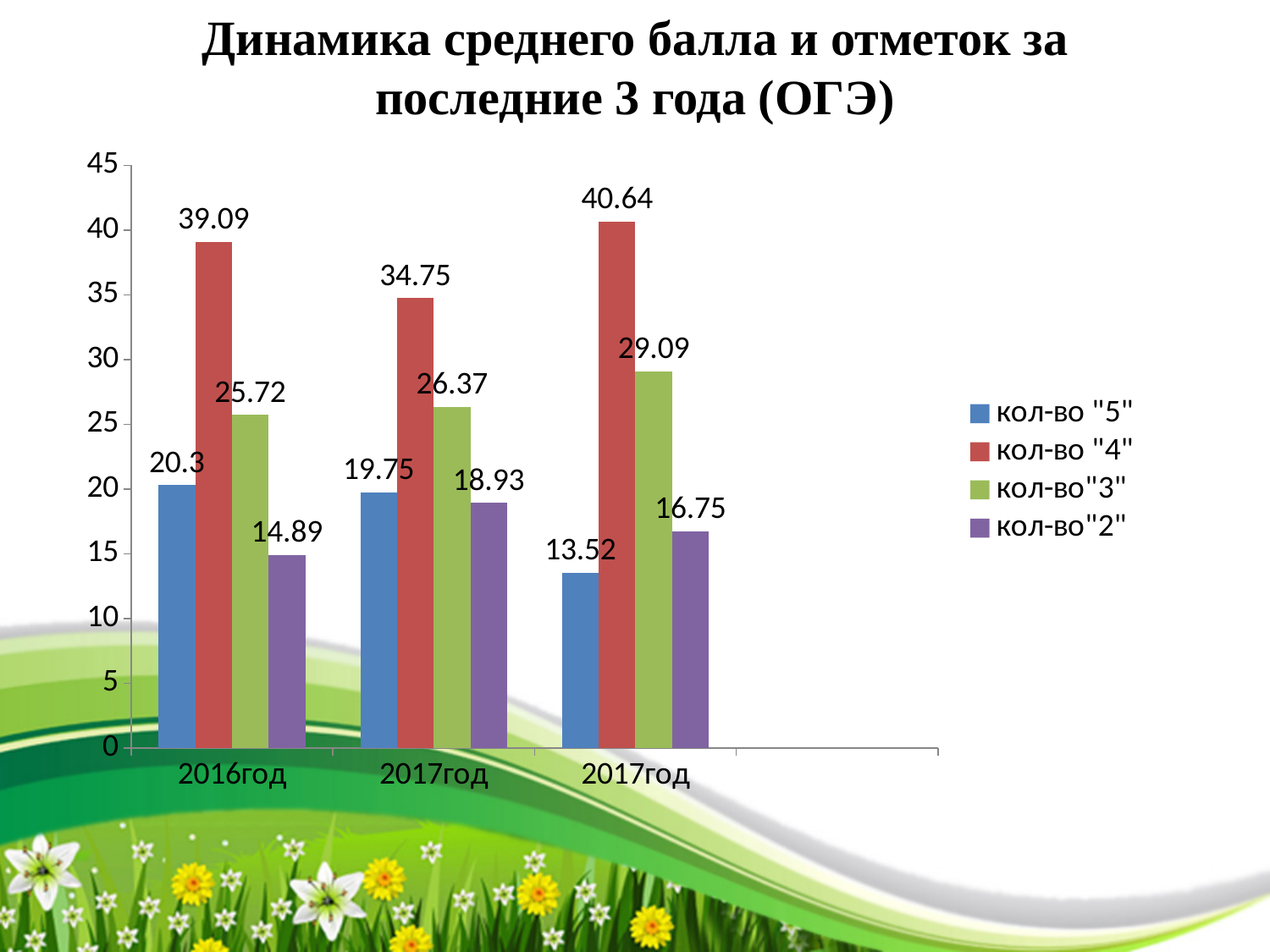
What is the difference between кол-во "4" and кол-во "5" for 2016год? 18.79 Which is larger: кол-во"3" in the middle group or кол-во"3" in the rightmost group? the rightmost group Does the value of кол-во "5" rise or fall from the leftmost group to the rightmost group? fall What is the value of кол-во"2" in the middle group of bars? 18.93 What is the value of кол-во "4" for 2016год? 39.09 Which series has the lowest value in the rightmost group of bars? кол-во "5" How many series does the legend list? 4 What is the value of кол-во "5" in the rightmost group of bars? 13.52 What colour are the bars for кол-во "4"? red How many groups of bars (categories) are shown on the x axis? 3 What kind of chart is shown on the slide? bar chart Which series has the highest value for 2016год? кол-во "4"